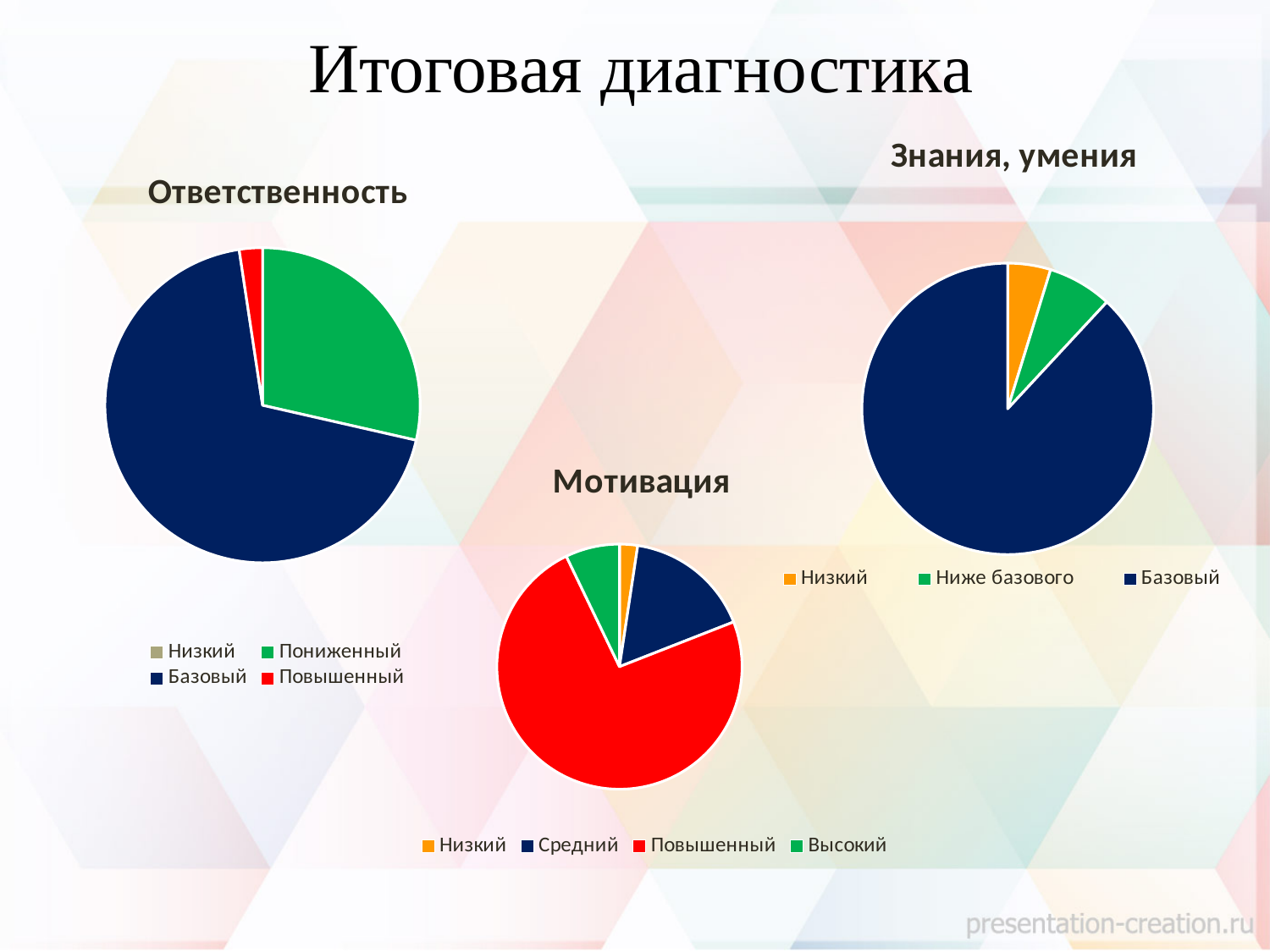
How many categories does the legend of the "Знания, умения" chart list? 3 How many pie charts are shown on the slide? 3 How many categories does the legend of the "Мотивация" chart list? 4 In the "Мотивация" chart, which category has the smallest slice? Низкий In the "Ответственность" chart, which category has the largest slice? Базовый In the "Знания, умения" chart, which category has the largest slice? Базовый What kind of chart is the "Ответственность" chart? pie chart In the "Мотивация" chart, which category has the largest slice? Повышенный In the "Ответственность" chart, which slice is larger: Базовый or Пониженный? Базовый In the "Знания, умения" chart, what colour is the Базовый slice? dark blue How many categories does the legend of the "Ответственность" chart list? 4 In the "Мотивация" chart, which slice is larger: Средний or Высокий? Средний